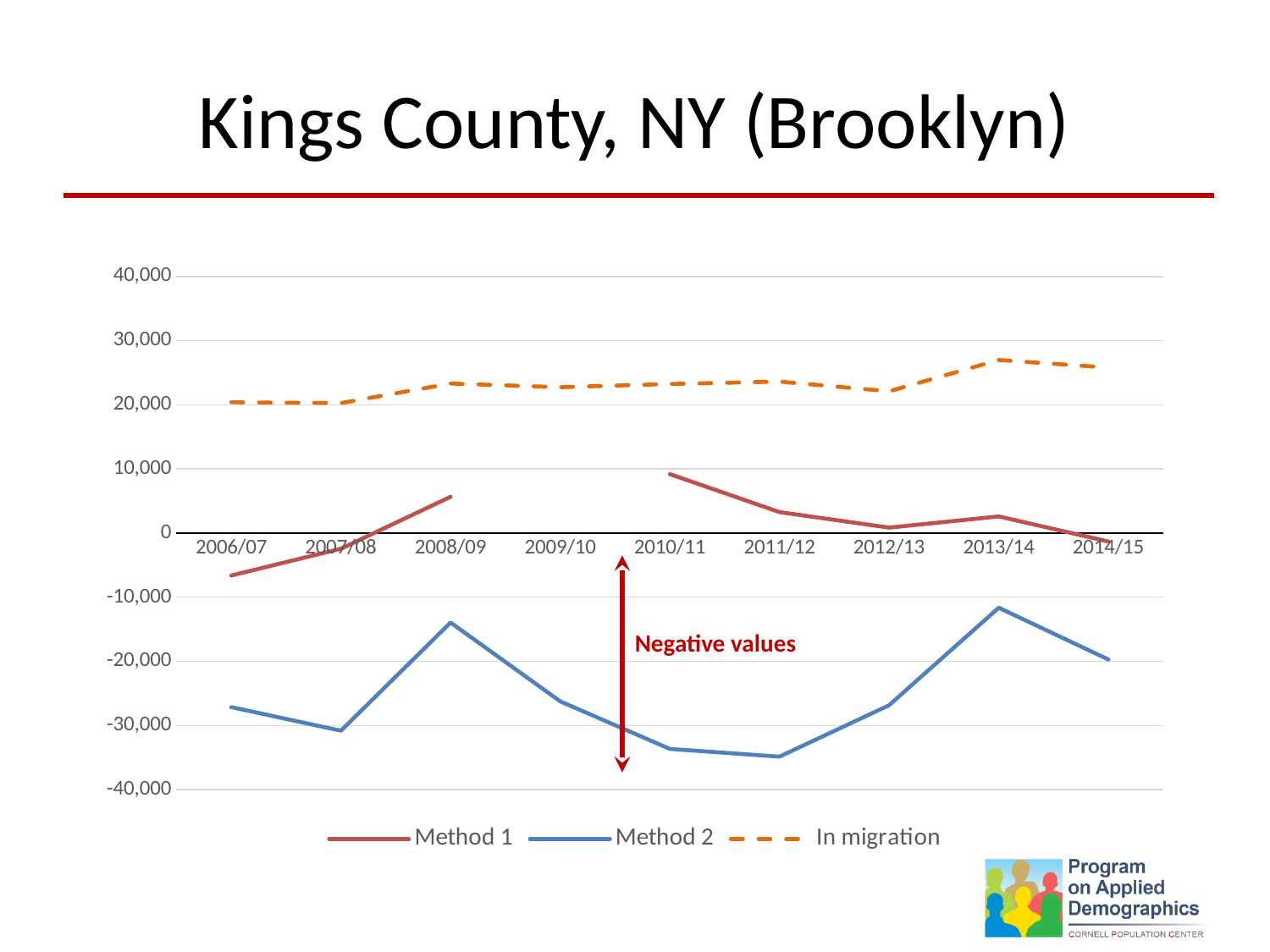
In which year does the Method 2 series reach its highest value? 2013/14 What kind of chart is shown on the slide? line chart Which series is drawn with a dashed line? In migration How many year categories are shown on the x axis? 9 Is the In migration value for 2013/14 greater or less than 20,000? greater Which series has the higher value in 2010/11, Method 1 or Method 2? Method 1 In which year does the In migration series reach its highest value? 2013/14 How many series does the legend list? 3 Is the Method 2 value for 2011/12 greater or less than -30,000? less Is the Method 1 value for 2006/07 greater or less than 0? less What is the title of the slide containing the chart? Kings County, NY (Brooklyn)